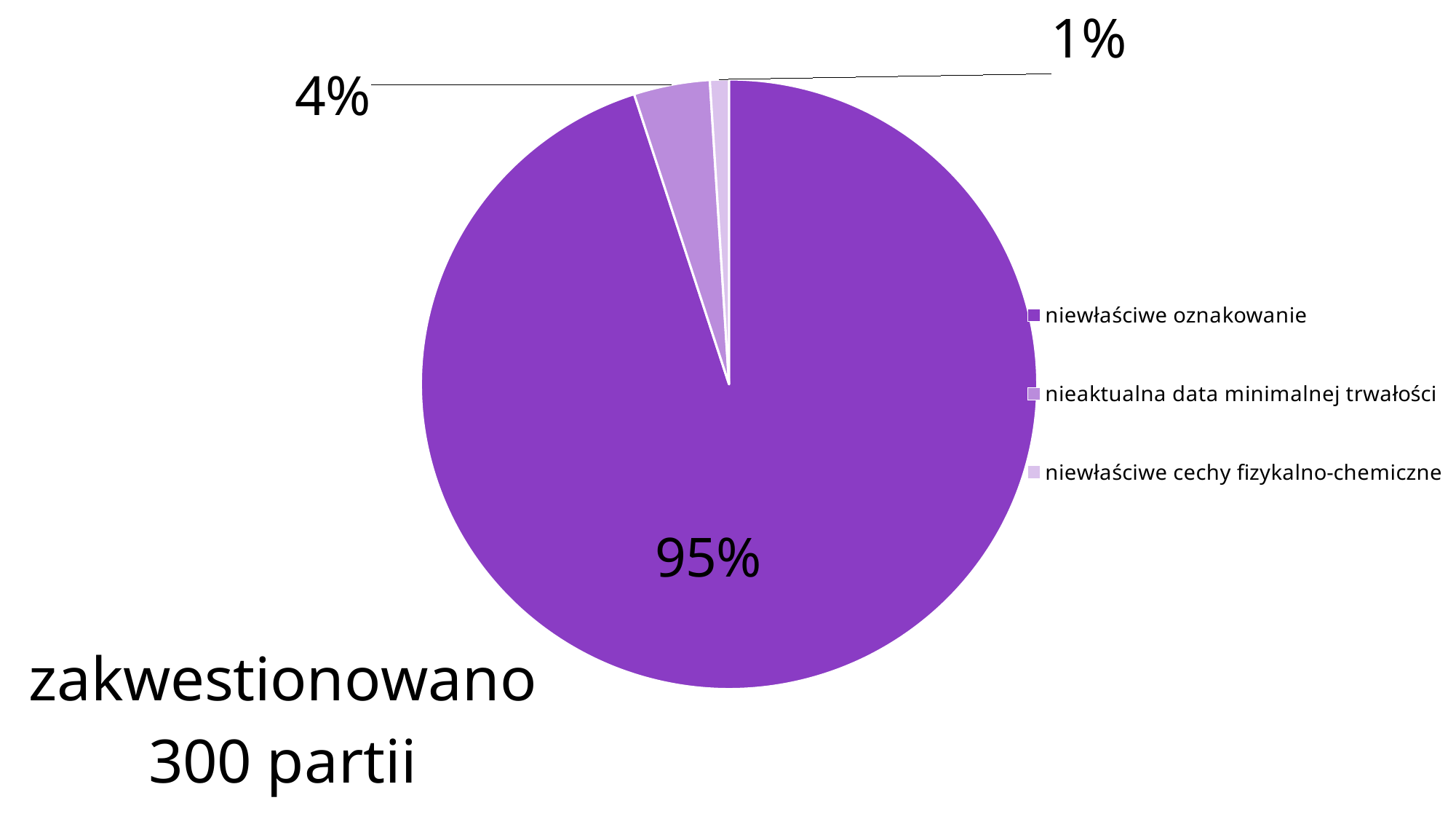
What is the difference in percentage points between "niewłaściwe oznakowanie" and "nieaktualna data minimalnej trwałości"? 91 What share of the pie does "nieaktualna data minimalnej trwałości" take? 4% Which category has the smallest slice of the pie? niewłaściwe cechy fizykalno-chemiczne What is the difference in percentage points between "nieaktualna data minimalnej trwałości" and "niewłaściwe cechy fizykalno-chemiczne"? 3 How many entries does the legend list? 3 What share of the pie does "niewłaściwe cechy fizykalno-chemiczne" take? 1% What kind of chart is shown on the slide? pie chart What text appears in the bottom-left corner of the slide next to the chart? zakwestionowano 300 partii What share of the pie does "niewłaściwe oznakowanie" take? 95% Which category has the largest slice of the pie? niewłaściwe oznakowanie How many categories does the pie chart show? 3 Which is larger: the slice for "nieaktualna data minimalnej trwałości" or the slice for "niewłaściwe cechy fizykalno-chemiczne"? nieaktualna data minimalnej trwałości